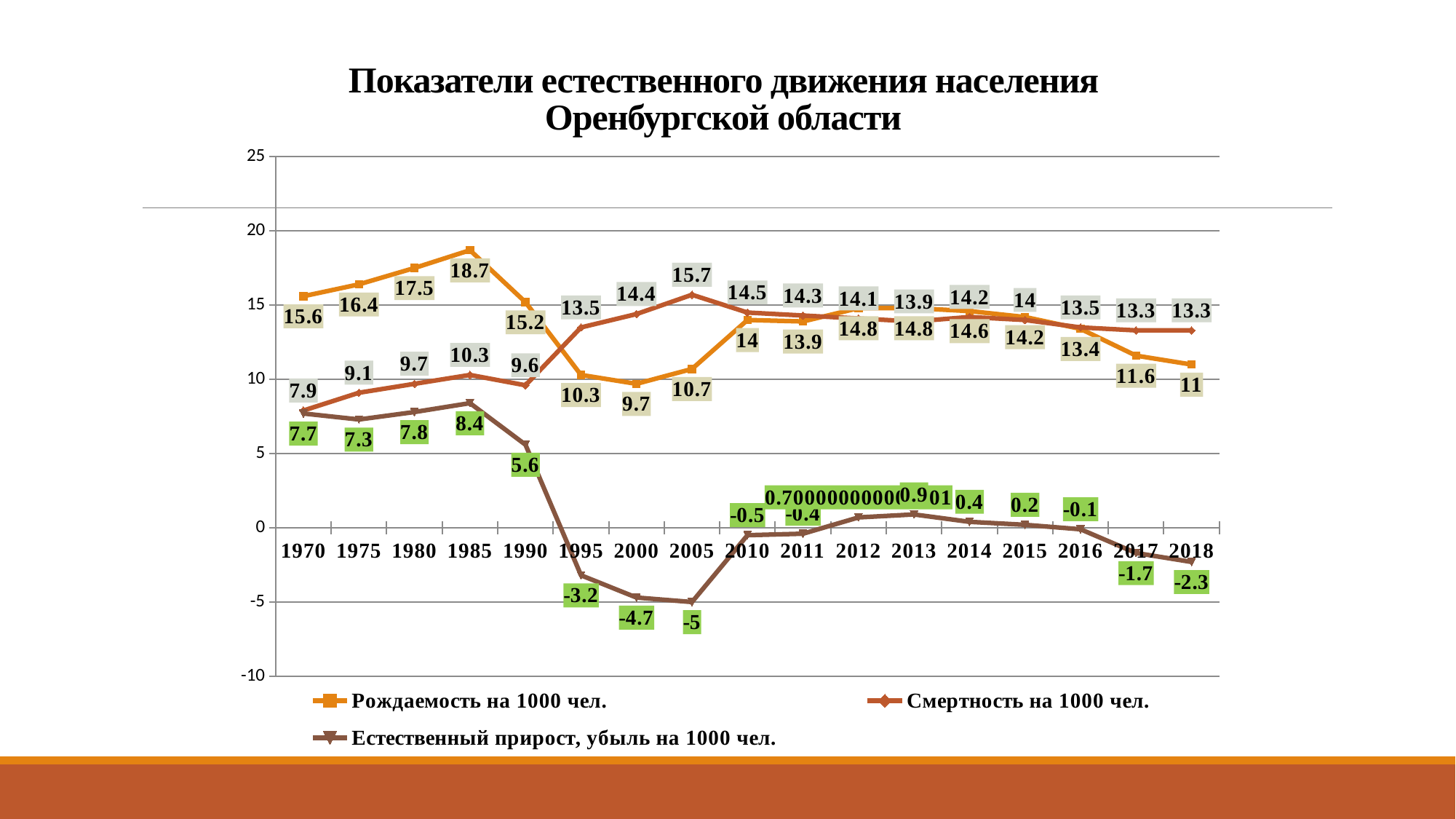
What is the title of the chart? Показатели естественного движения населения Оренбургской области Does Рождаемость на 1000 чел. rise or fall from 2013 to 2018? fall What is the difference between Рождаемость на 1000 чел. in 1985 and in 2018? 7.7 What is the value of Смертность на 1000 чел. in 2005? 15.7 How many series does the legend list? 3 What is the value of Естественный прирост, убыль на 1000 чел. in 1990? 5.6 In 1970, which is larger: Рождаемость на 1000 чел. or Смертность на 1000 чел.? Рождаемость на 1000 чел. What is the value of Рождаемость на 1000 чел. in 1985? 18.7 How many years are plotted along the x axis? 17 In which year is Рождаемость на 1000 чел. highest? 1985 What kind of chart is shown on the slide? line chart In which year is Естественный прирост, убыль на 1000 чел. lowest? 2005